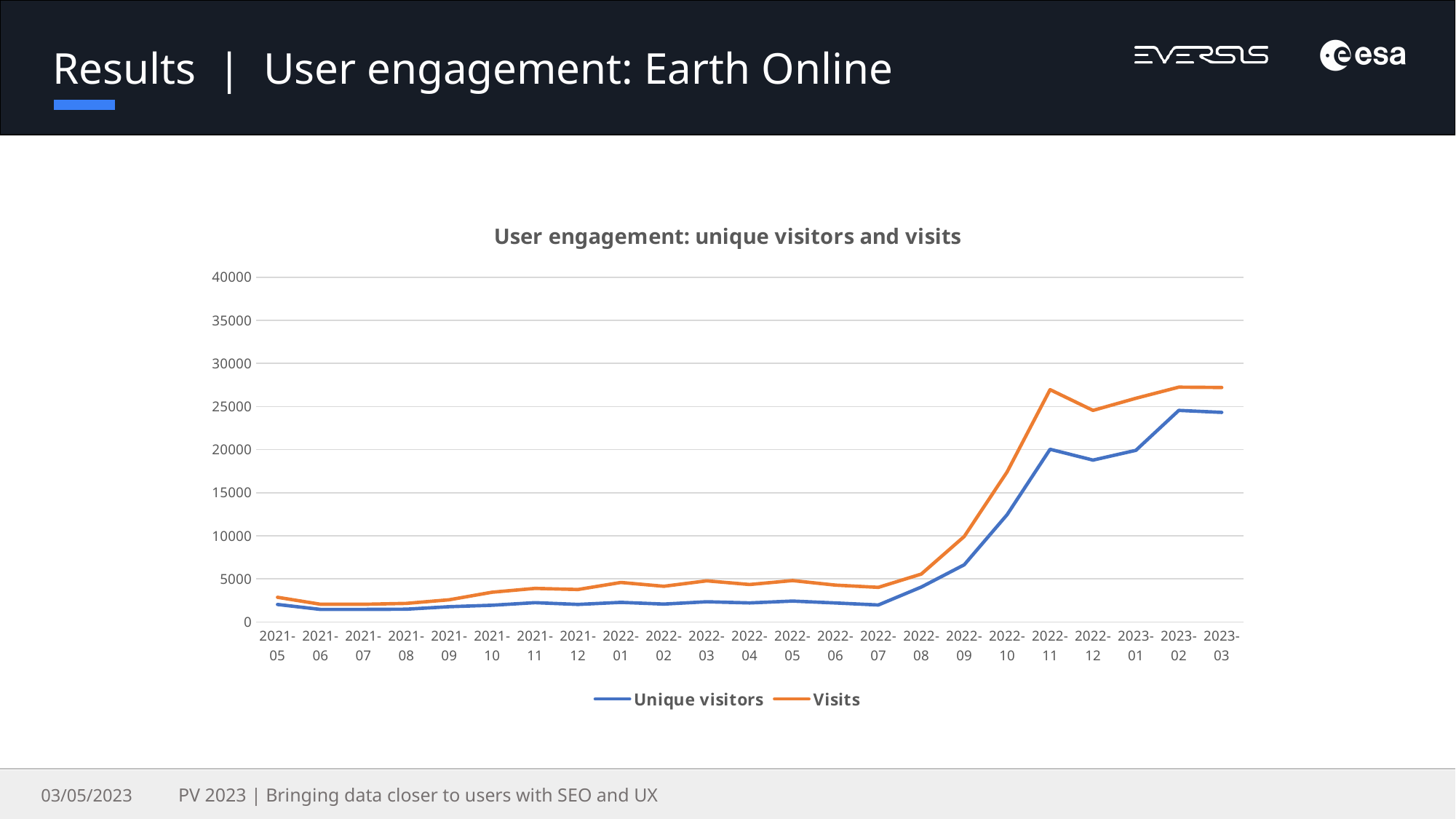
Is the value for Unique visitors in 2022-12 greater or less than 20000? less What is the title of the chart? User engagement: unique visitors and visits How many months are plotted along the x axis? 23 Which colour is used for the Visits line? Orange Is the value for Visits in 2022-11 greater or less than 25000? greater For Visits, which month has the larger value, 2022-11 or 2022-12? 2022-11 Is the value for Unique visitors in 2022-10 greater or less than 10000? greater What kind of chart is shown on the slide? Line chart Overall, do the Unique visitors values rise or fall from 2021-05 to 2023-03? Rise In 2022-11, which series has the larger value, Visits or Unique visitors? Visits How many series does the legend list? 2